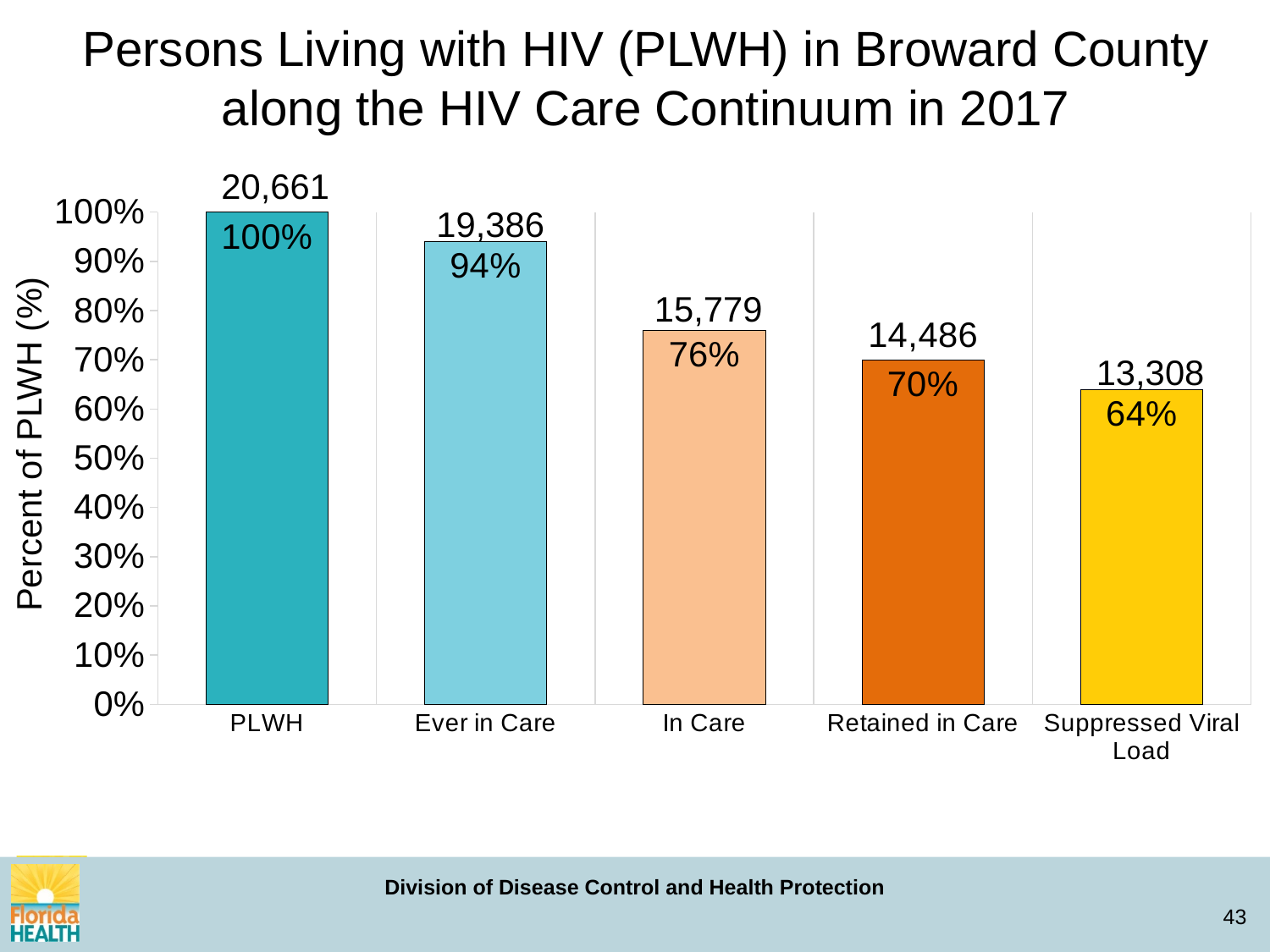
What is the difference in number of persons between PLWH and Ever in Care? 1,275 Is the value for Retained in Care greater or less than 80%? less Which category has the highest value? PLWH How many categories are shown on the x axis? 5 What percentage of PLWH is shown for Suppressed Viral Load? 64% Do the values rise or fall from left to right along the x axis? fall What percentage of PLWH is shown for the Ever in Care category? 94% What kind of chart is shown on the slide? bar chart How many persons are shown in the Retained in Care category? 14,486 Which category has the lowest value? Suppressed Viral Load What is the difference in percentage points between In Care and Retained in Care? 6% Which is larger, the value for In Care or the value for Suppressed Viral Load? In Care